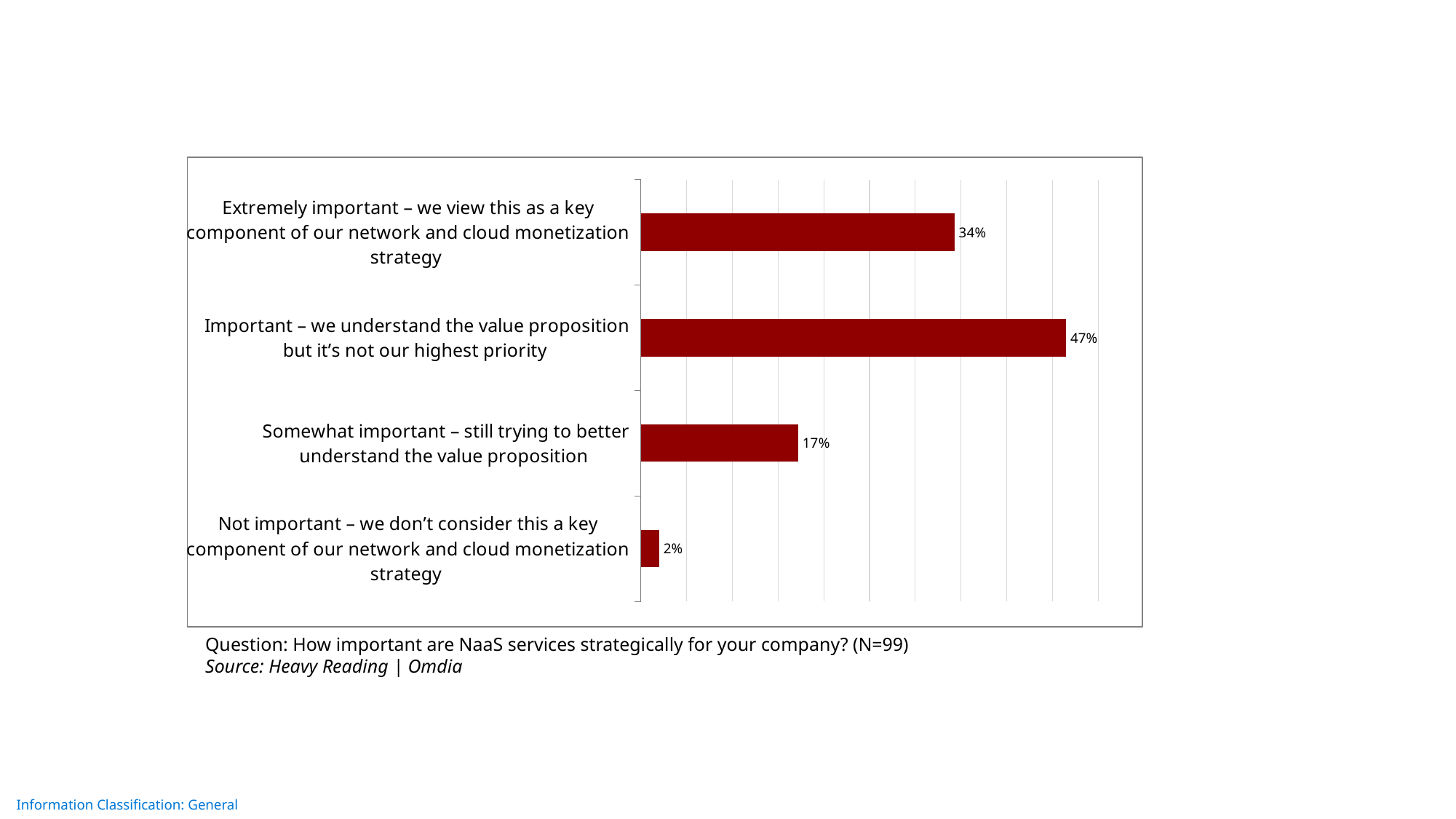
Which is larger: the value for 'Extremely important' or the value for 'Somewhat important'? Extremely important Which response category has the highest percentage? Important – we understand the value proposition but it's not our highest priority What percentage of respondents chose 'Important – we understand the value proposition but it's not our highest priority'? 47% What percentage of respondents said NaaS services are 'Not important'? 2% What is the difference in percentage points between 'Somewhat important' and 'Not important'? 15 What is the value for 'Somewhat important – still trying to better understand the value proposition'? 17% How many response categories are shown in the chart? 4 Which response category has the lowest percentage? Not important – we don't consider this a key component of our network and cloud monetization strategy What type of chart is shown on the slide? Bar chart According to the note below the chart, how many respondents (N) answered the survey question? 99 What percentage of respondents said NaaS services are 'Extremely important'? 34% What is the difference in percentage points between 'Important' and 'Extremely important'? 13